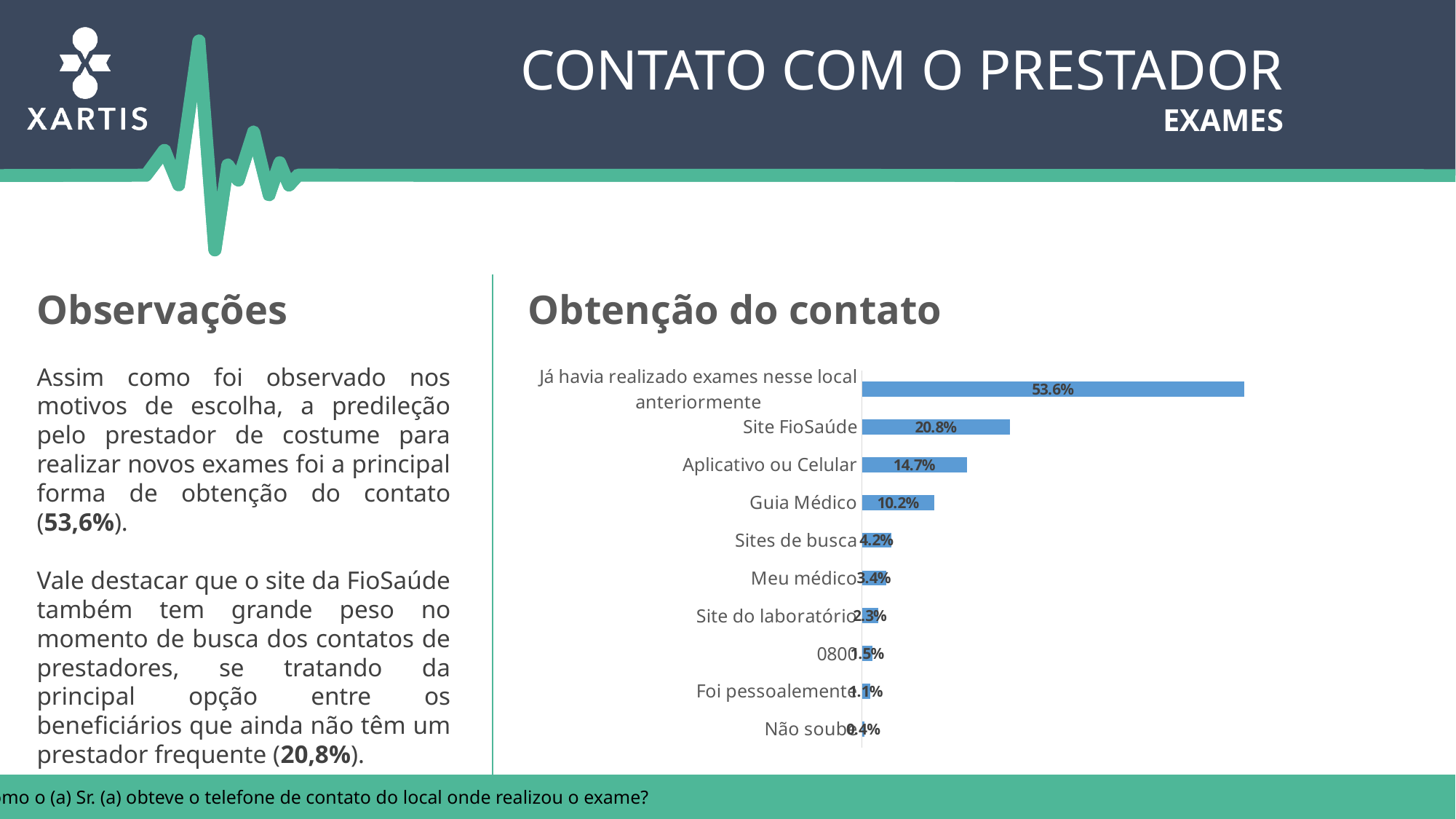
What is the title of the chart? Obtenção do contato What is the difference between the values for "Site FioSaúde" and "Aplicativo ou Celular"? 6.1% What is the value for "Meu médico"? 3.4% Which category has the highest value? Já havia realizado exames nesse local anteriormente How many categories does the chart show? 10 What is the value for "Guia Médico"? 10.2% What is the value for "Aplicativo ou Celular"? 14.7% What kind of chart is shown under "Obtenção do contato"? bar chart Which is larger, the value for "Guia Médico" or the value for "Sites de busca"? Guia Médico What is the value for "Site FioSaúde"? 20.8% Which category has the lowest value? Não soube What is the value for "Sites de busca"? 4.2%